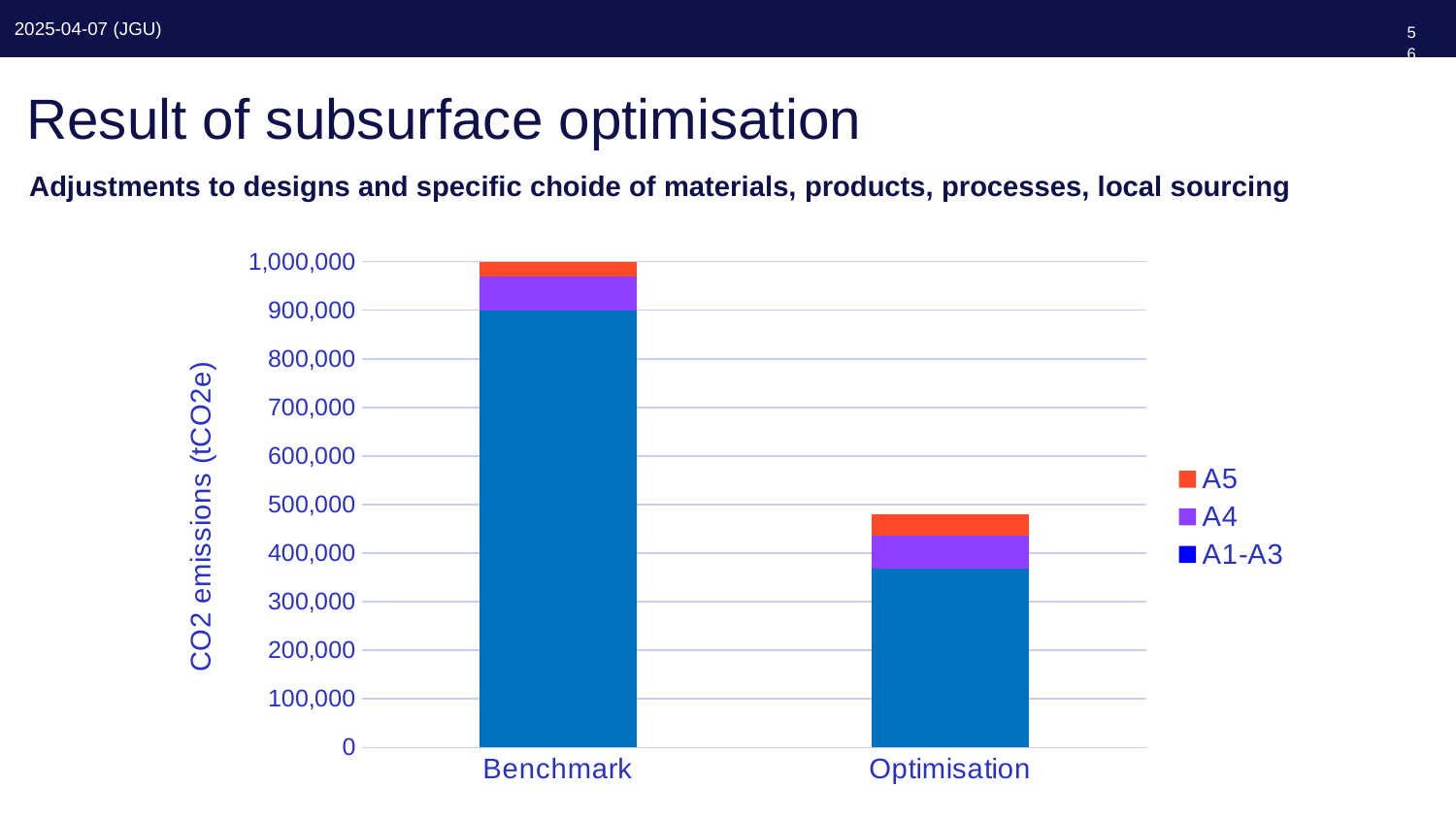
Is the A1-A3 value for Optimisation greater or less than 400,000? less How many categories are shown on the x axis of the chart? 2 Is the A1-A3 value for Benchmark greater or less than 800,000? greater Is the total value for Optimisation greater or less than 500,000? less What is the label of the y axis of the chart? CO2 emissions (tCO2e) How many series does the chart legend list? 3 Do the total CO2 emissions rise or fall from Benchmark to Optimisation? fall Which category has the lowest total CO2 emissions? Optimisation Which category has the higher total CO2 emissions, Benchmark or Optimisation? Benchmark What kind of chart is shown on the slide? Stacked bar chart Which series are listed in the chart legend? A5, A4, A1-A3